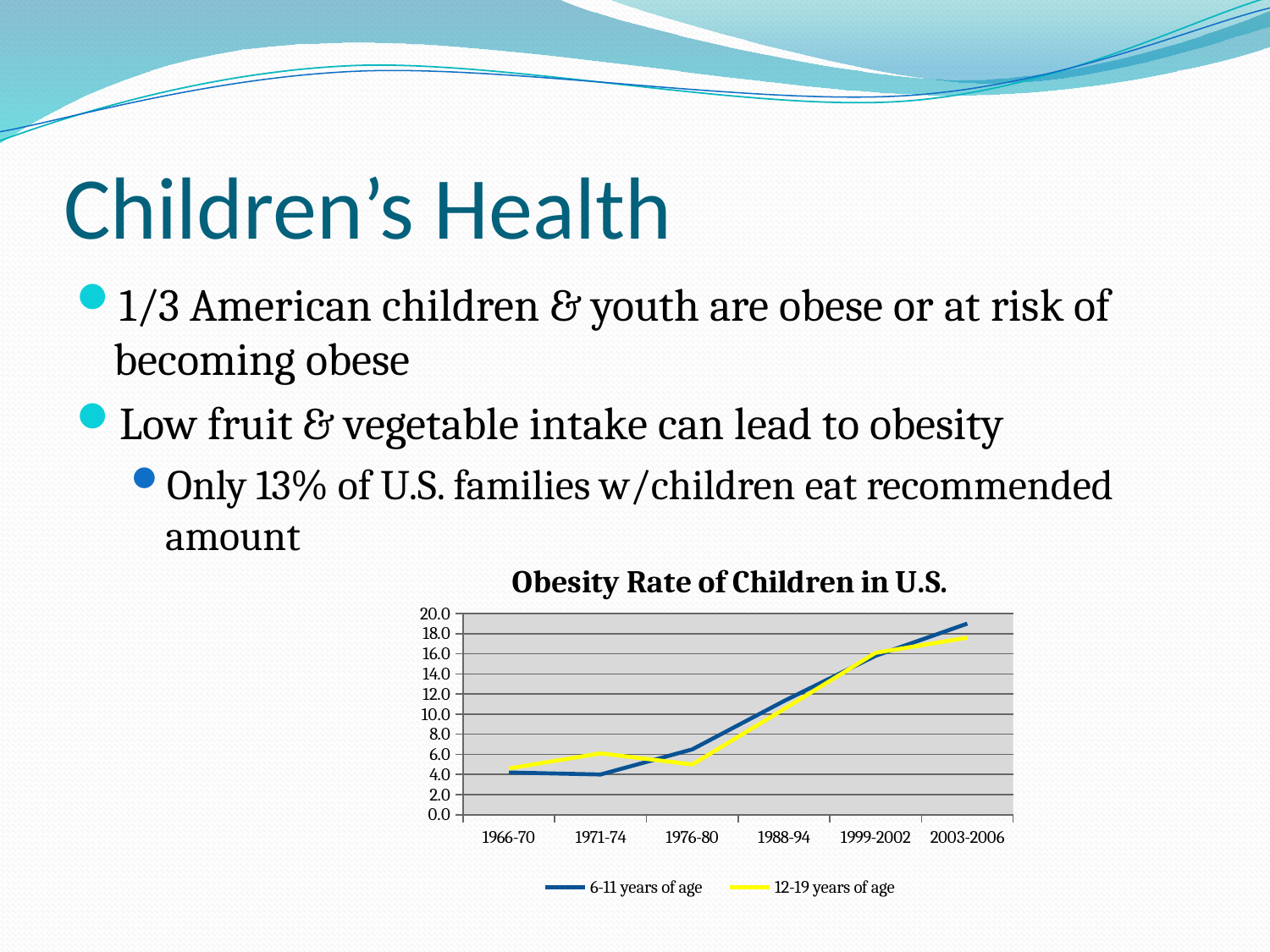
Is the value for 6-11 years of age in 1971-74 greater or less than 6.0? less In 1971-74, which series has the higher obesity rate, 6-11 years of age or 12-19 years of age? 12-19 years of age How many series does the chart's legend list? 2 How many time periods are shown on the x axis of the chart? 6 What is the title of the chart? Obesity Rate of Children in U.S. In 2003-2006, which series has the higher obesity rate, 6-11 years of age or 12-19 years of age? 6-11 years of age Is the value for 12-19 years of age in 1988-94 greater or less than 8.0? greater Do the obesity rates for 6-11 years of age generally rise or fall from 1966-70 to 2003-2006? rise What kind of chart is shown on the slide? line chart Is the value for 6-11 years of age in 2003-2006 greater or less than 18.0? greater Which series is drawn in yellow in the chart? 12-19 years of age In which period is the obesity rate for 6-11 years of age highest? 2003-2006